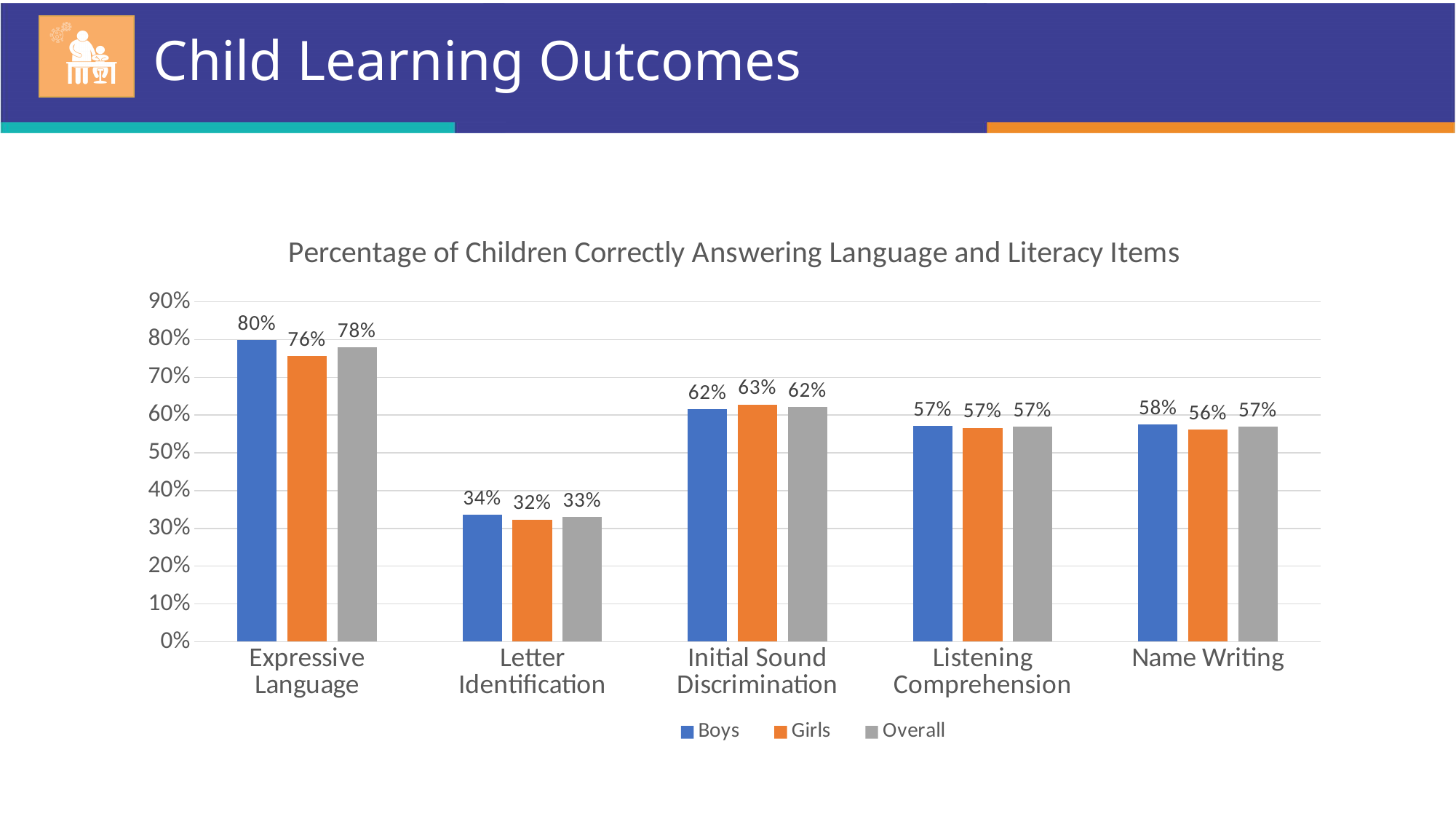
What is the title of the chart? Percentage of Children Correctly Answering Language and Literacy Items What is the difference between the Boys and Girls values for Expressive Language? 4% How many series does the legend list? 3 Is the Overall value for Name Writing greater or less than 50%? greater Which category has the lowest value for Girls? Letter Identification Which is larger for Letter Identification, the Boys value or the Girls value? Boys What kind of chart is shown on the slide? Bar chart How many categories are shown on the x axis? 5 What is the Overall value for Letter Identification? 33% What percentage of boys correctly answered Expressive Language items? 80% Which category has the highest Overall value? Expressive Language What percentage of girls correctly answered Initial Sound Discrimination items? 63%